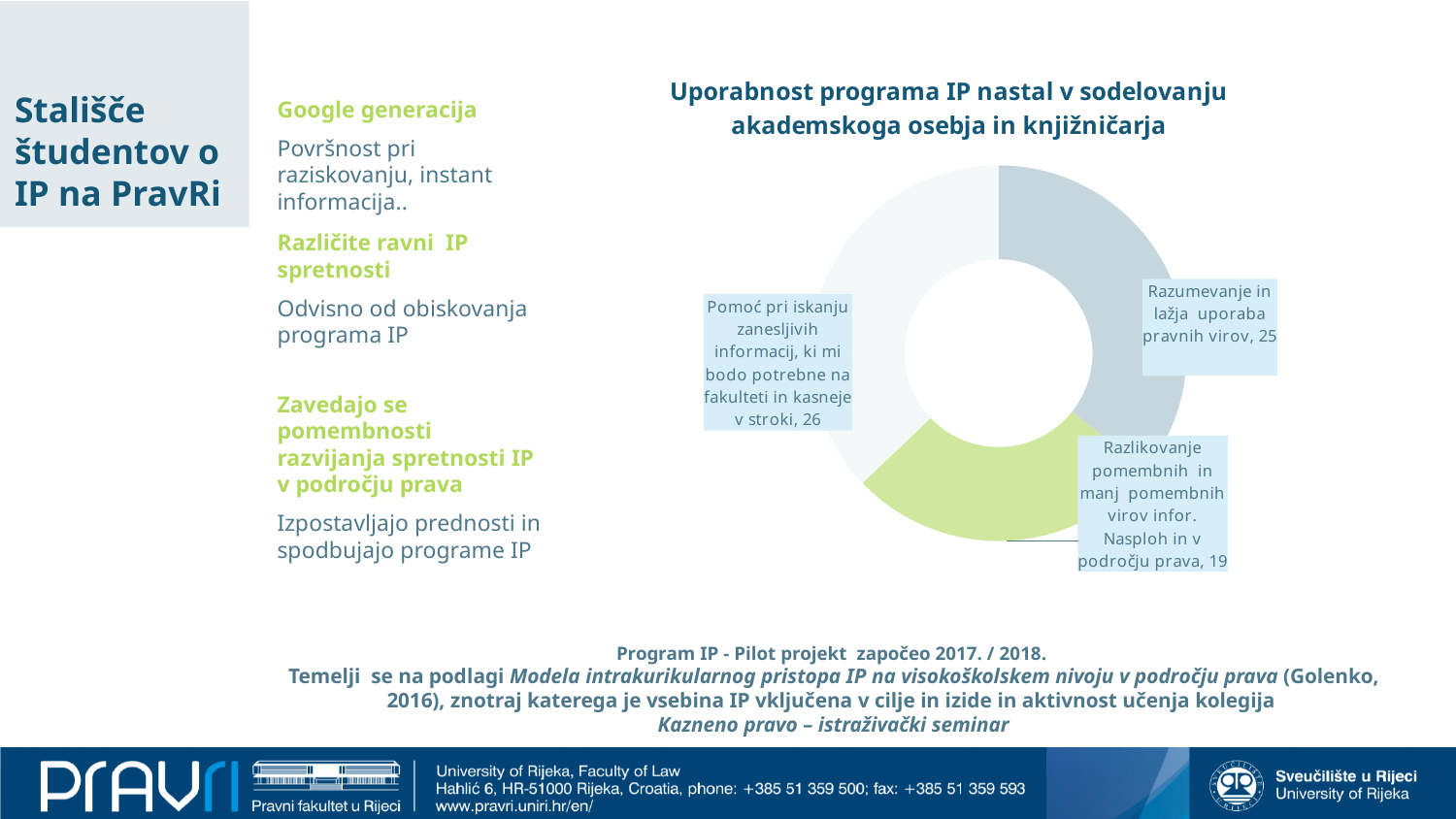
What is the value for 'Razlikovanje pomembnih in manj pomembnih virov infor. Nasploh in v področju prava'? 19 What is the value for 'Razumevanje in lažja uporaba pravnih virov'? 25 Which is larger: the value for 'Razumevanje in lažja uporaba pravnih virov' or for 'Razlikovanje pomembnih in manj pomembnih virov infor...'? Razumevanje in lažja uporaba pravnih virov What is the title of the chart? Uporabnost programa IP nastal v sodelovanju akademskoga osebja in knjižničarja What is the difference between the values for 'Pomoč pri iskanju zanesljivih informacij...' and 'Razlikovanje pomembnih in manj pomembnih virov infor...'? 7 Which category has the highest value in the chart? Pomoč pri iskanju zanesljivih informacij, ki mi bodo potrebne na fakulteti in kasneje v stroki What is the value for 'Pomoč pri iskanju zanesljivih informacij, ki mi bodo potrebne na fakulteti in kasneje v stroki'? 26 What is the total of all the values shown in the chart? 70 What kind of chart is shown on the slide? Doughnut (pie) chart What is the difference between the values for 'Razumevanje in lažja uporaba pravnih virov' and 'Razlikovanje pomembnih in manj pomembnih virov infor...'? 6 How many categories (slices) does the chart have? 3 Which category has the lowest value in the chart? Razlikovanje pomembnih in manj pomembnih virov infor. Nasploh in v področju prava